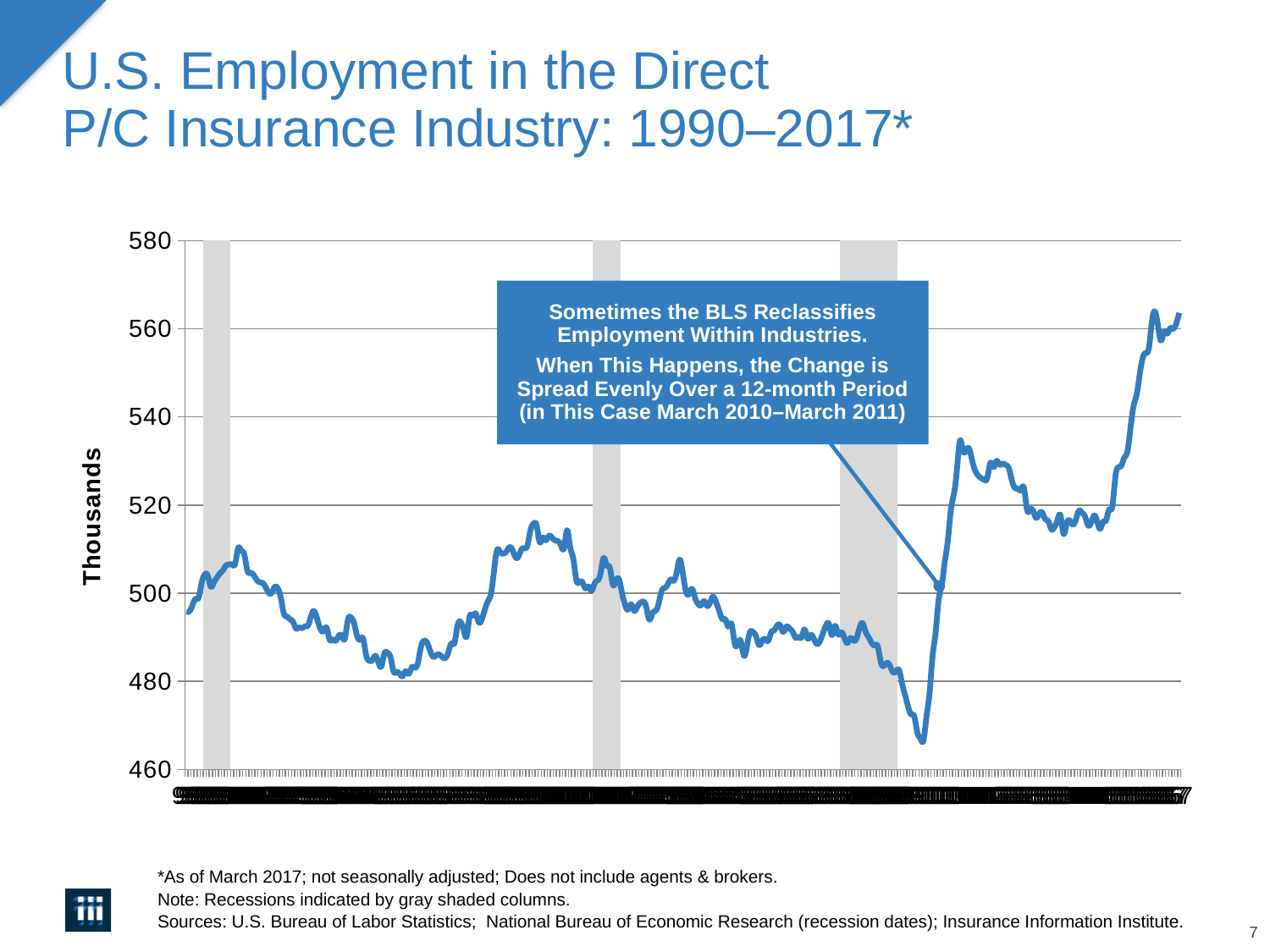
Is the value at the left-hand start of the line (1990) greater or less than 520? less What is the title of the chart on the slide? U.S. Employment in the Direct P/C Insurance Industry: 1990–2017* According to the callout box, over which period was the BLS reclassification change spread? March 2010–March 2011 How many gray shaded recession columns appear on the chart? 3 What is the label on the vertical axis of the chart? Thousands Is the lowest point of the employment line greater or less than 480? less Is the value at the right-hand end of the line (2017) greater or less than 540? greater What kind of chart is shown on the slide? line chart Comparing the start of the series to the end of the series, does employment rise or fall overall? rise